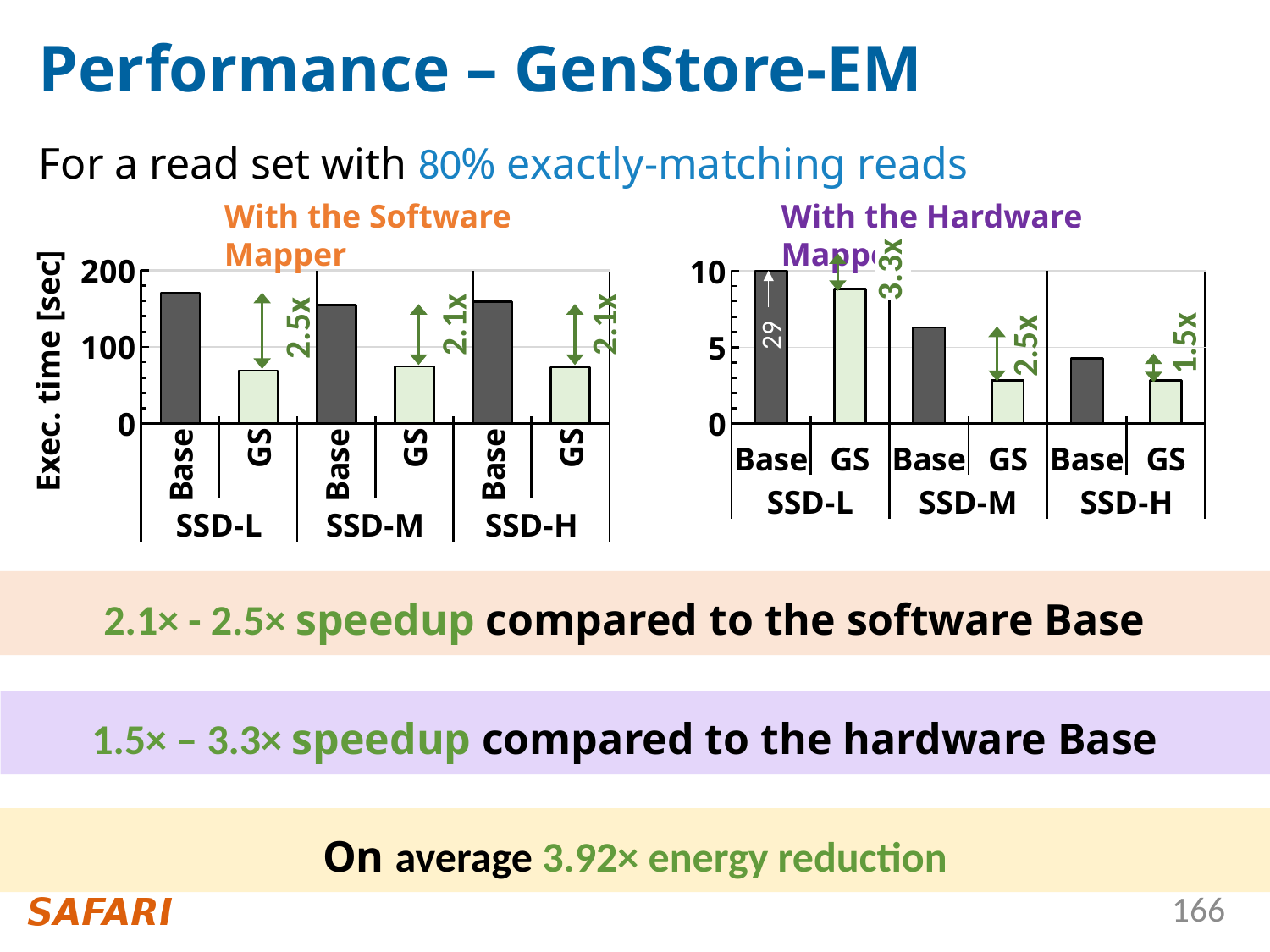
In the 'With the Software Mapper' chart, which bar is the highest? Base for SSD-L In the 'With the Hardware Mapper' chart, what value is labelled on the Base bar for SSD-L? 29 In the 'With the Software Mapper' chart, which is larger: the Base value for SSD-L or the Base value for SSD-M? Base for SSD-L In the 'With the Hardware Mapper' chart, is the GS value for SSD-H greater or less than 5? less In the 'With the Software Mapper' chart, is the Base value for SSD-L greater or less than 100? greater In the 'With the Hardware Mapper' chart, what speedup is annotated for SSD-L? 3.3x In the 'With the Software Mapper' chart, is the GS value for SSD-L greater or less than 100? less What kind of chart is the 'With the Software Mapper' chart? bar chart In the 'With the Software Mapper' chart, what speedup is annotated for SSD-M? 2.1x What is the y-axis label of the 'With the Software Mapper' chart? Exec. time [sec] In the 'With the Software Mapper' chart, what speedup is annotated for SSD-L? 2.5x In the 'With the Hardware Mapper' chart, what speedup is annotated for SSD-H? 1.5x